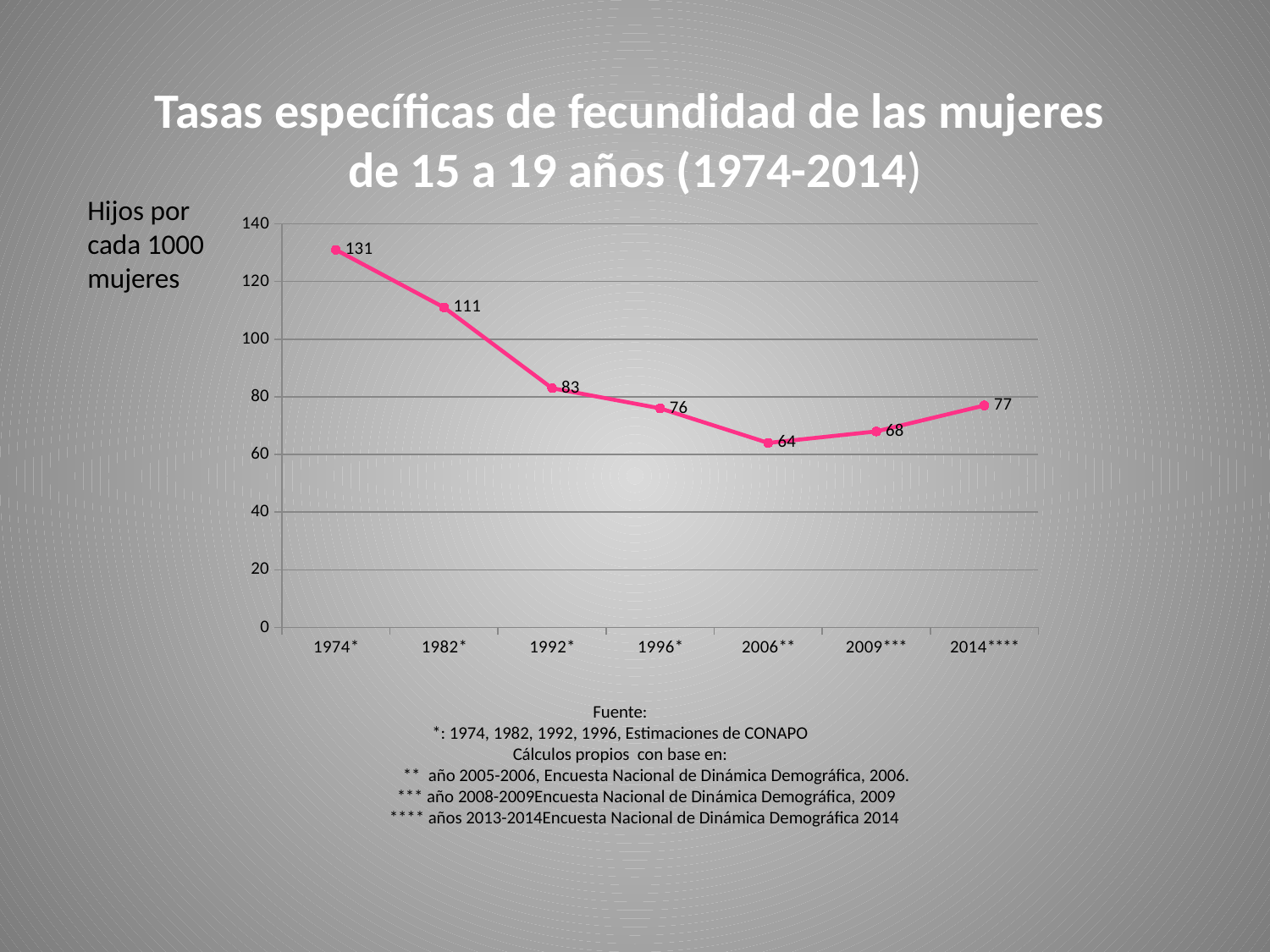
What is the value for 2006**? 64 Is the value for 1982* greater or less than 100? greater What is the difference between the values for 2014**** and 2006**? 13 What is the value for 2014****? 77 What is the value for 1974*? 131 Do the values rise or fall from 1974* to 2006**? fall Which is larger, the value for 1992* or the value for 1996*? 1992* What kind of chart is shown on the slide? line chart Which year has the highest value? 1974* How many data points are plotted on the chart? 7 What is the difference between the values for 1974* and 1982*? 20 Which year has the lowest value? 2006**